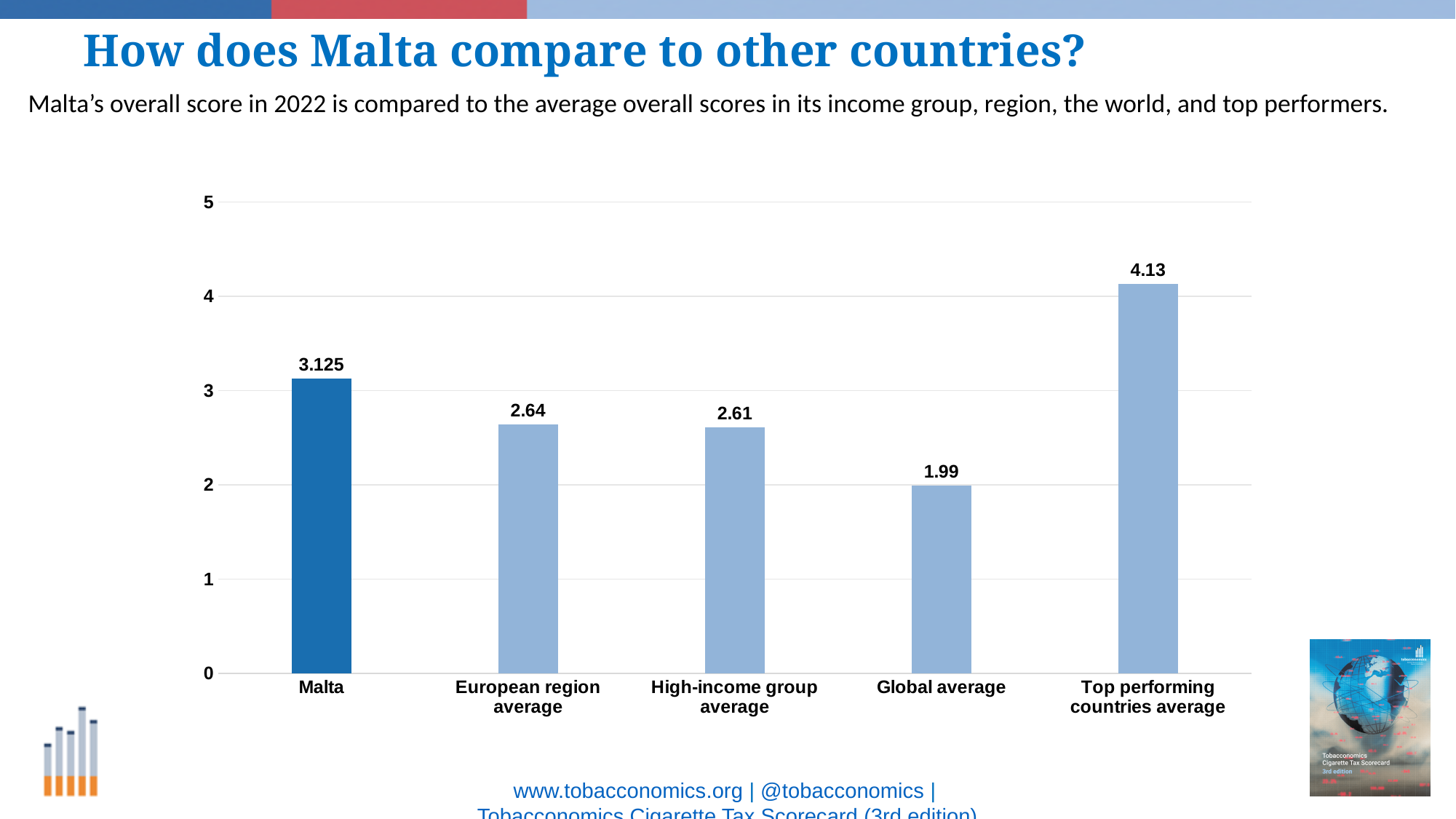
Which category has the lowest value? Global average What is the difference between the Top performing countries average and Malta? 1.005 What is the value shown for the Top performing countries average? 4.13 What is the difference between the High-income group average and the Global average? 0.62 How many categories are shown on the chart? 5 What is the value shown for the Global average? 1.99 Which is larger, Malta or the European region average? Malta What kind of chart is shown on the slide? Bar chart What is the value shown for Malta? 3.125 Which category has the highest value? Top performing countries average Is the value for the Global average greater or less than 2? less What is the value shown for the European region average? 2.64